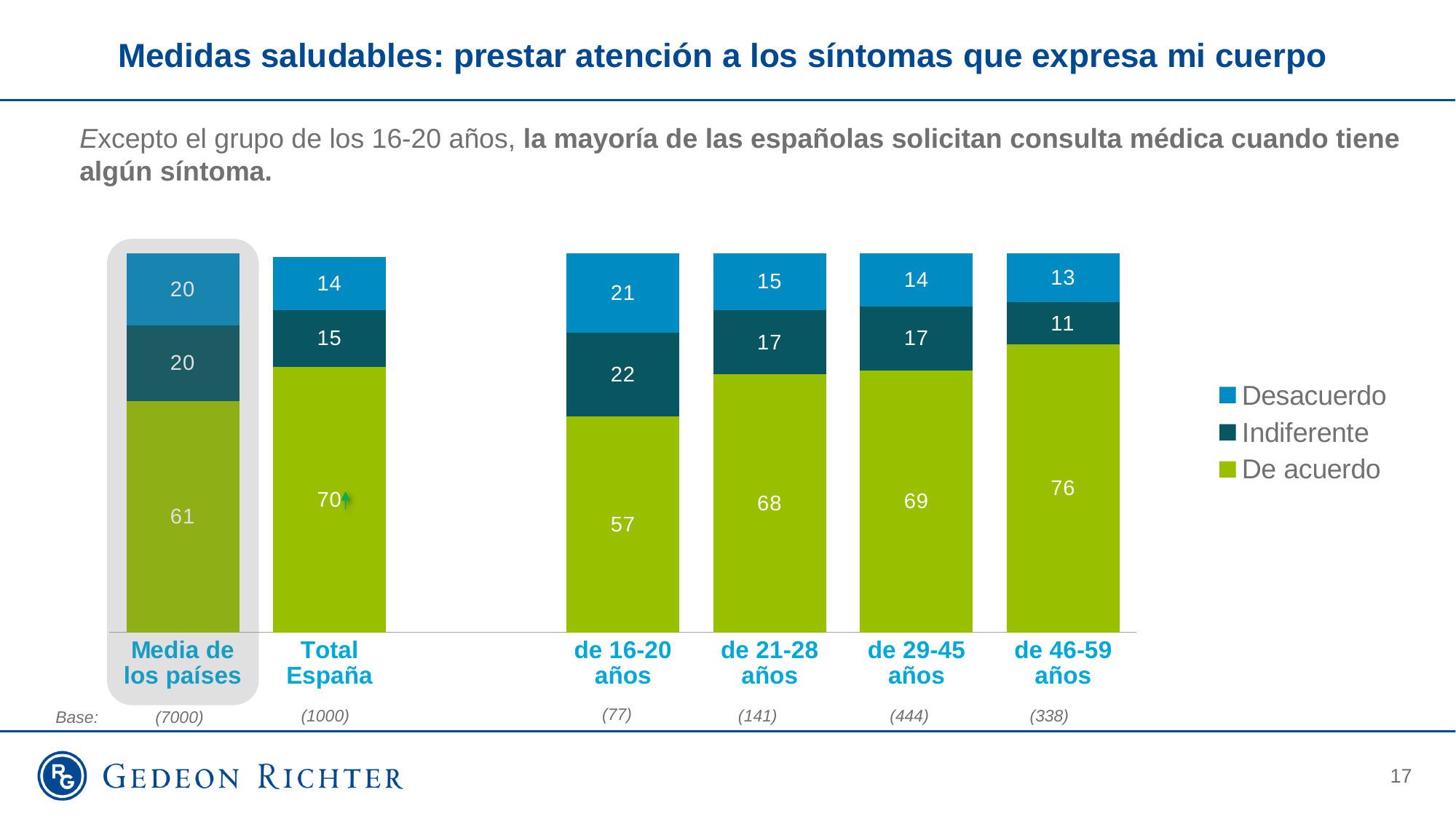
What is the 'Indiferente' value for the 'de 16-20 años' group? 22 How many series does the legend list? 3 Which is larger: the 'Indiferente' value for 'Media de los países' or for Total España? Media de los países How many categories are shown on the x axis? 6 Which category has the lowest 'De acuerdo' value? de 16-20 años Which legend entry is shown in light green? De acuerdo What is the 'De acuerdo' value for Total España? 70 Which category has the highest 'De acuerdo' value? de 46-59 años What is the total of the stacked bar for 'de 21-28 años'? 100 What is the 'Desacuerdo' value for 'Media de los países'? 20 What is the difference between the 'De acuerdo' values for 'de 46-59 años' and 'de 16-20 años'? 19 What kind of chart is shown on the slide? Stacked bar chart